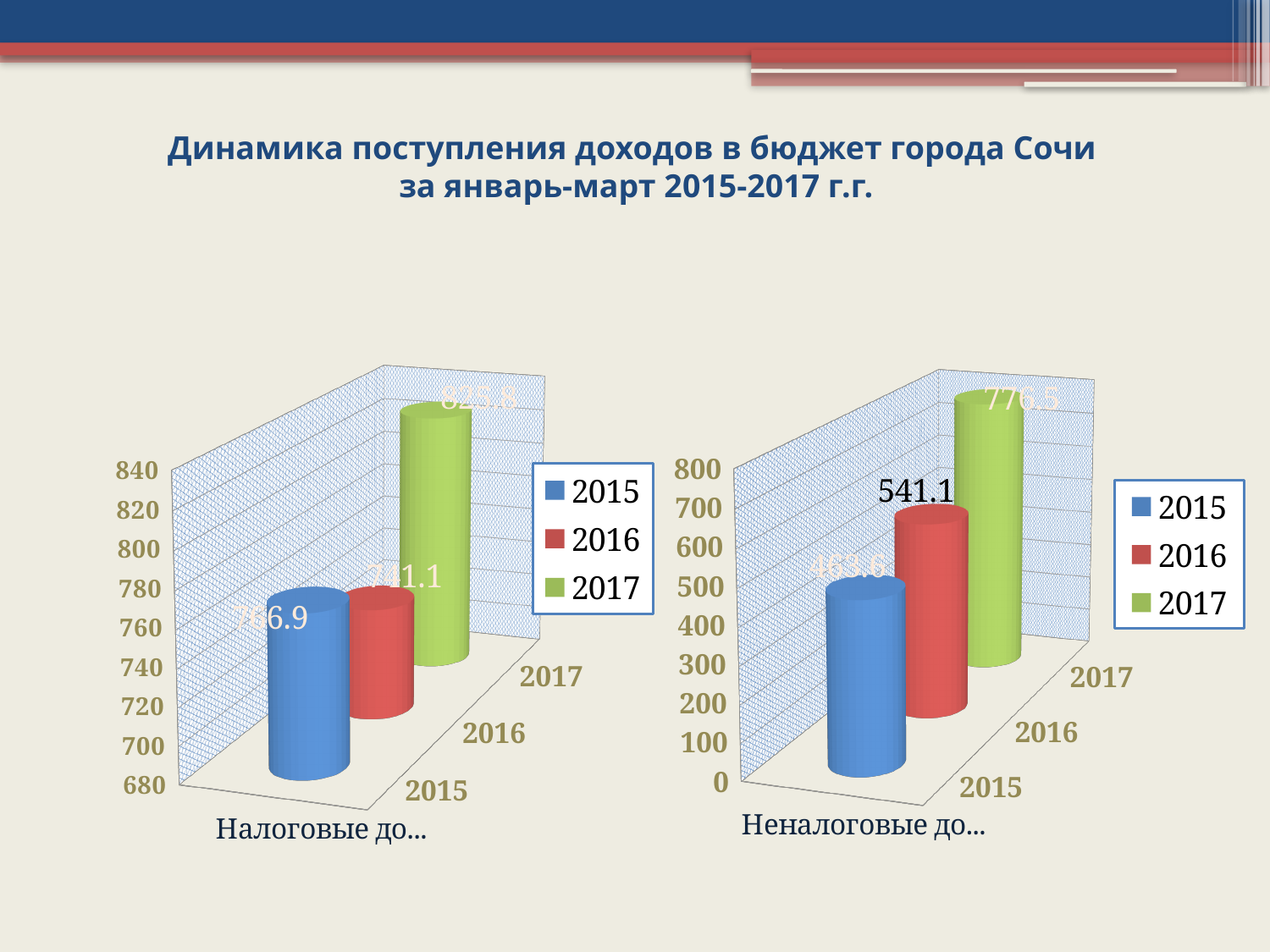
In the right chart, which year has the lowest value? 2015 How many series does the legend of the right chart list? 3 In the right chart, what is the value for 2016? 541.1 In the left chart, what is the difference between the 2017 and 2015 values? 58.9 In the right chart, what is the value for 2015? 463.6 In the left chart, which year has the highest value? 2017 In the right chart, is the value for 2016 larger than the value for 2015? Yes, 2016 (541.1) is larger In the left chart, what is the value for 2017? 825.8 In the left chart, which year has the lowest value? 2016 What type of chart is the left chart? Bar chart In the right chart, what is the difference between the 2017 and 2015 values? 312.9 In the left chart, what is the value for 2015? 766.9